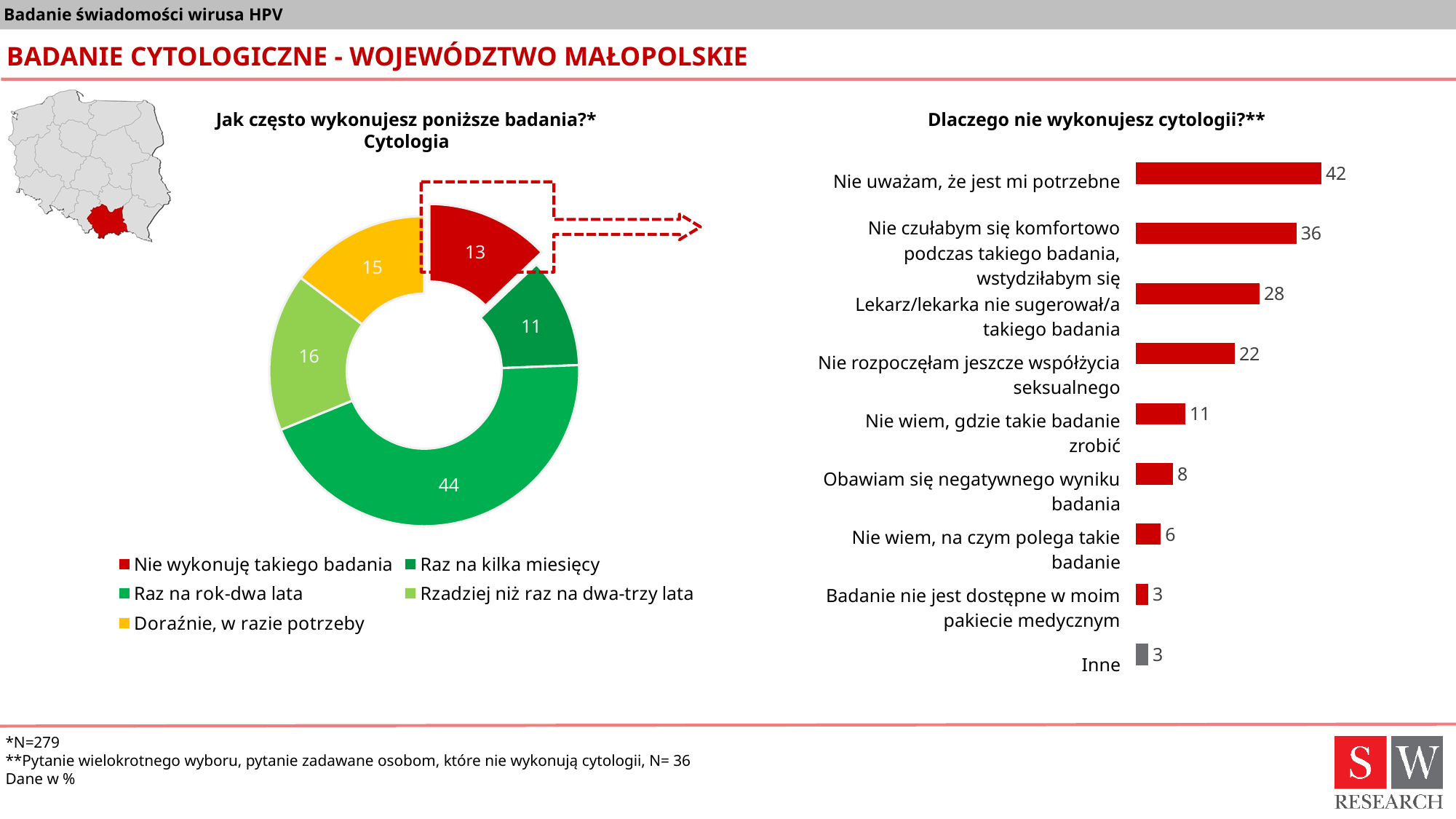
In the chart 'Dlaczego nie wykonujesz cytologii?**', what is the value for 'Nie uważam, że jest mi potrzebne'? 42 In the chart 'Dlaczego nie wykonujesz cytologii?**', what is the difference between 'Nie uważam, że jest mi potrzebne' and 'Lekarz/lekarka nie sugerował/a takiego badania'? 14 In the chart 'Jak często wykonujesz poniższe badania?* Cytologia', which category has the largest share? Raz na rok-dwa lata In the chart 'Dlaczego nie wykonujesz cytologii?**', what is the value for 'Nie wiem, gdzie takie badanie zrobić'? 11 In the chart 'Jak często wykonujesz poniższe badania?* Cytologia', what is the value for 'Nie wykonuję takiego badania'? 13 In the chart 'Jak często wykonujesz poniższe badania?* Cytologia', what is the value for 'Raz na rok-dwa lata'? 44 In the chart 'Jak często wykonujesz poniższe badania?* Cytologia', which category has the smallest share? Raz na kilka miesięcy In the chart 'Dlaczego nie wykonujesz cytologii?**', which is larger: 'Nie rozpoczęłam jeszcze współżycia seksualnego' or 'Obawiam się negatywnego wyniku badania'? Nie rozpoczęłam jeszcze współżycia seksualnego What kind of chart is 'Jak często wykonujesz poniższe badania?* Cytologia'? Doughnut (pie) chart In the chart 'Jak często wykonujesz poniższe badania?* Cytologia', how many categories does the legend list? 5 In the chart 'Dlaczego nie wykonujesz cytologii?**', how many categories are shown? 9 What kind of chart is 'Dlaczego nie wykonujesz cytologii?**'? Bar chart